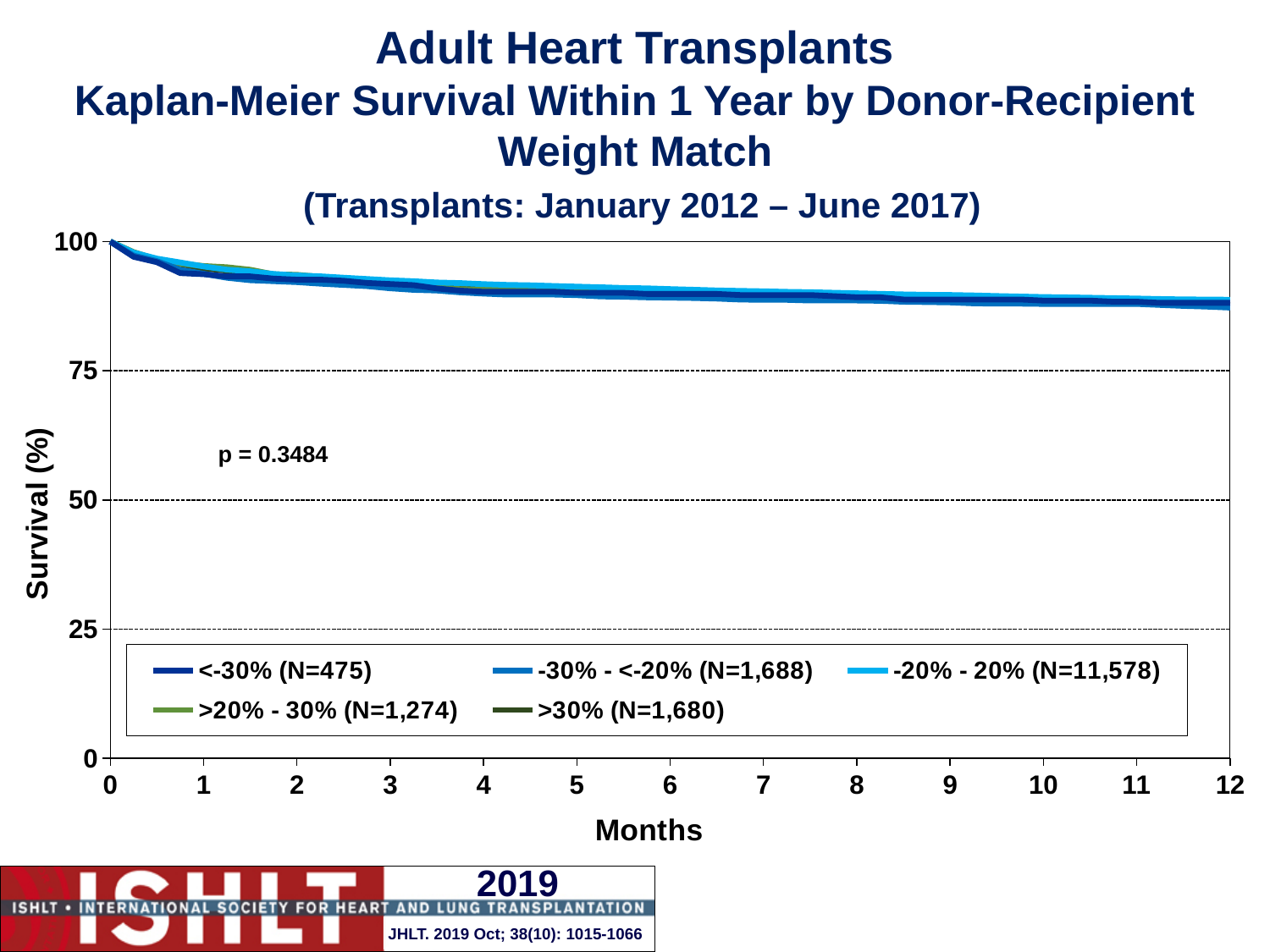
Which group in the legend has the smallest N? <-30% (N=475) What is the p-value printed on the chart? p = 0.3484 Is the survival value for the -20% - 20% group at 12 months greater or less than 75? greater What is the N for the -20% - 20% group shown in the legend? 11,578 What kind of chart is shown on the slide? line chart How many series does the legend list? 5 Which group in the legend has the largest N? -20% - 20% (N=11,578) Do the survival curves rise or fall as months increase from 0 to 12? fall Which group has a larger N, >20% - 30% or >30%? >30% (N=1,680) Is the survival value for the <-30% group at 6 months greater or less than 75? greater What is the N for the <-30% group shown in the legend? 475 What is the label of the y axis? Survival (%)